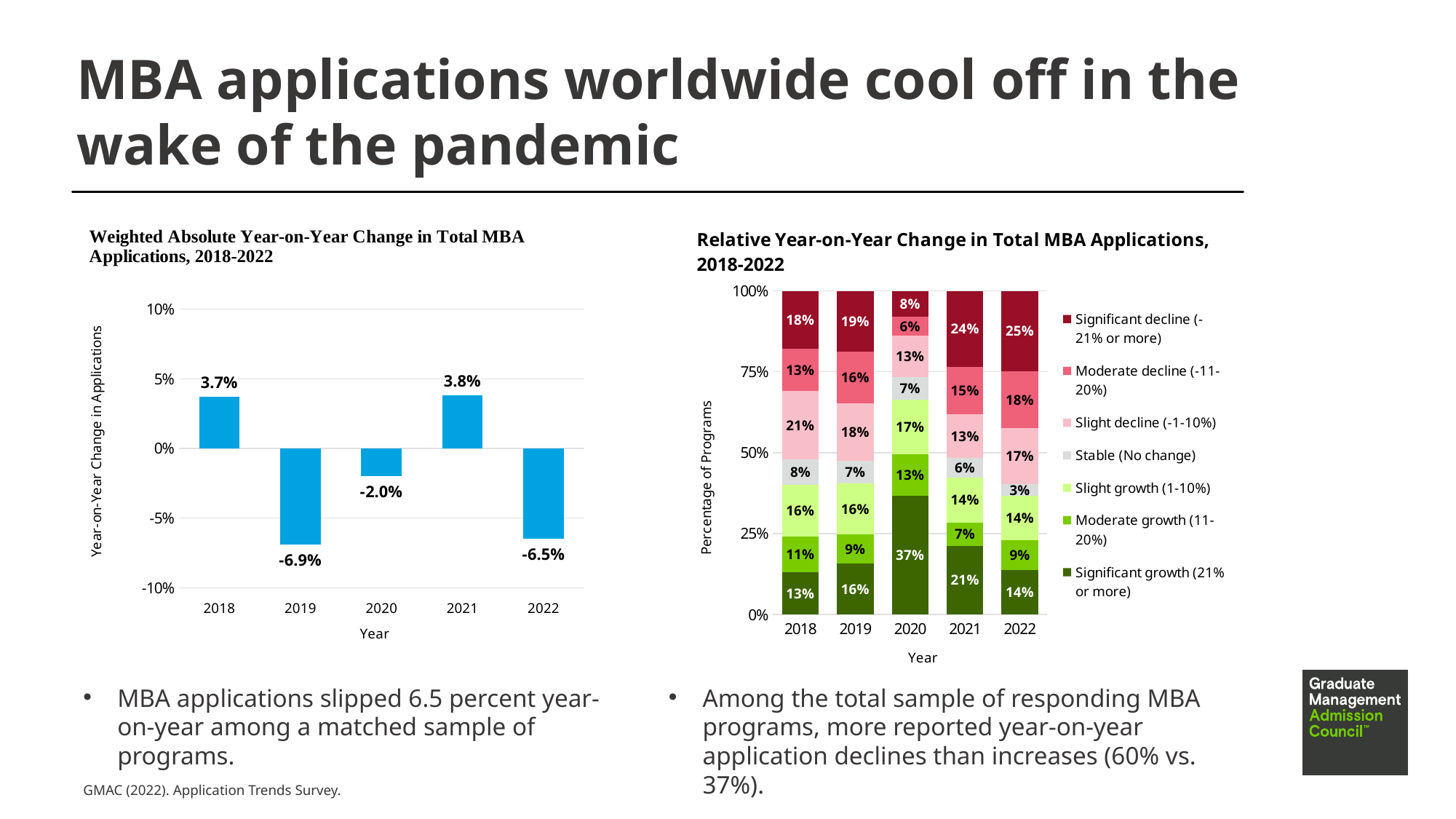
In the Weighted Absolute Year-on-Year Change chart, what is the value for 2019? -6.9% In the Weighted Absolute Year-on-Year Change chart, which year has the lowest value? 2019 In the Relative Year-on-Year Change chart, what is the difference between the Stable (No change) share in 2018 and in 2022? 5% In the Weighted Absolute Year-on-Year Change chart, how many years are plotted? 5 In the Weighted Absolute Year-on-Year Change chart, which year has the highest value? 2021 In the Relative Year-on-Year Change chart, which year has the highest Significant decline (-21% or more) share? 2022 In the Relative Year-on-Year Change chart, which is larger: the Moderate decline (-11-20%) share in 2022 or in 2021? 2022 In the Relative Year-on-Year Change chart, how many series does the legend list? 7 In the Relative Year-on-Year Change chart, what percentage of programs reported Significant decline (-21% or more) in 2022? 25% What kind of chart is the Weighted Absolute Year-on-Year Change chart? Bar chart In the Relative Year-on-Year Change chart, what percentage of programs reported Significant growth (21% or more) in 2020? 37% In the Weighted Absolute Year-on-Year Change chart, what is the difference between the 2021 value and the 2018 value? 0.1%